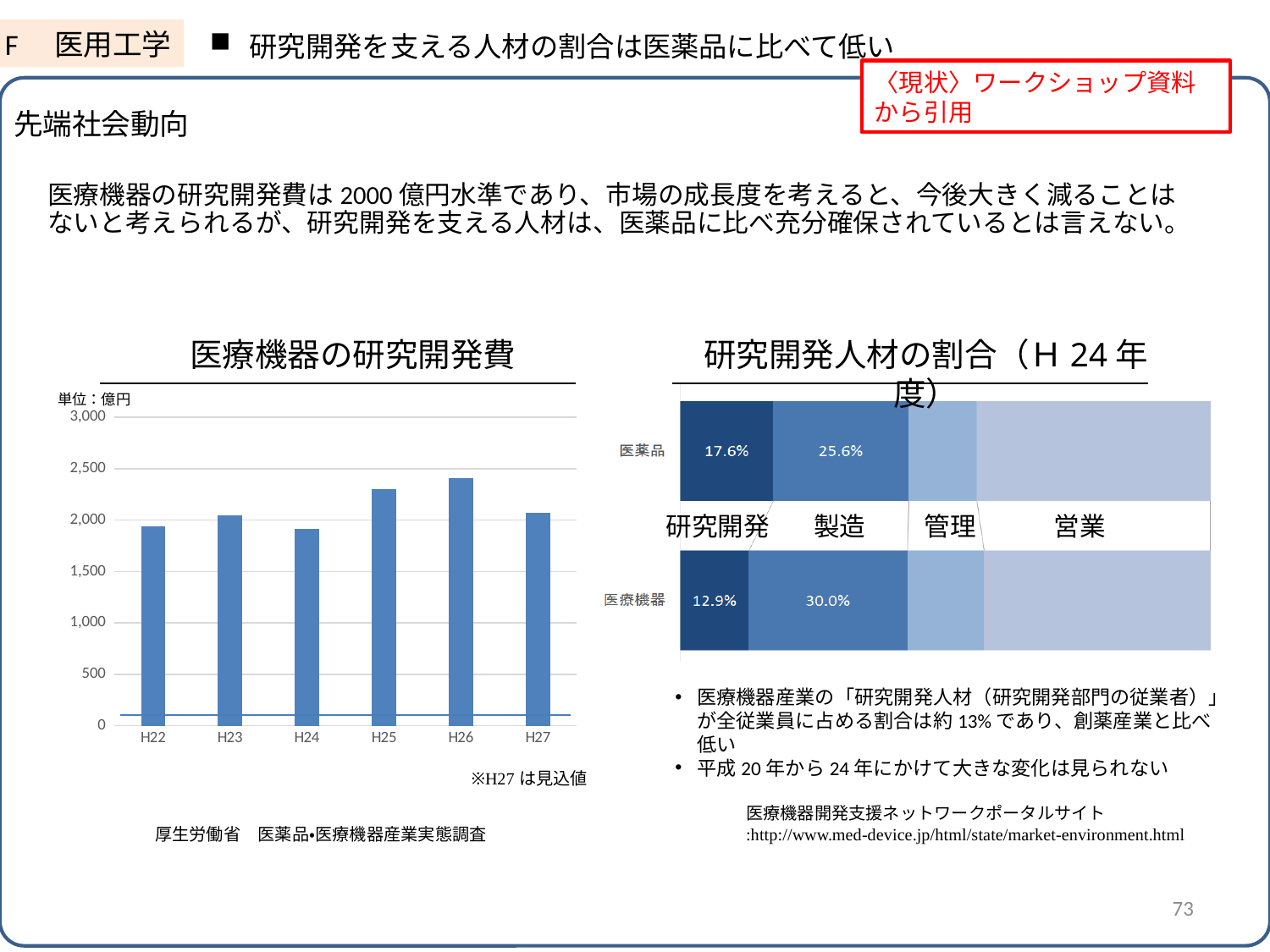
In the right chart 研究開発人材の割合（H24年度）, how many segments make up each stacked bar? 4 In the left chart 医療機器の研究開発費, which year has the highest value? H26 In the left chart 医療機器の研究開発費, how many years are shown on the x axis? 6 In the right chart 研究開発人材の割合（H24年度）, which has the larger 研究開発 share, 医薬品 or 医療機器? 医薬品 In the right chart 研究開発人材の割合（H24年度）, what is the 研究開発 share for 医薬品? 17.6% In the left chart 医療機器の研究開発費, is the value for H25 greater or less than 2,000? greater In the left chart 医療機器の研究開発費, is the value for H24 greater or less than 2,000? less In the right chart 研究開発人材の割合（H24年度）, what is the 製造 share for 医療機器? 30.0% What kind of chart is the left chart titled 医療機器の研究開発費? bar chart In the left chart 医療機器の研究開発費, is the value for H26 greater or less than 2,500? less In the left chart 医療機器の研究開発費, what unit is stated for the values? 億円 In the right chart 研究開発人材の割合（H24年度）, what is the difference between the 研究開発 share of 医薬品 and that of 医療機器? 4.7 percentage points